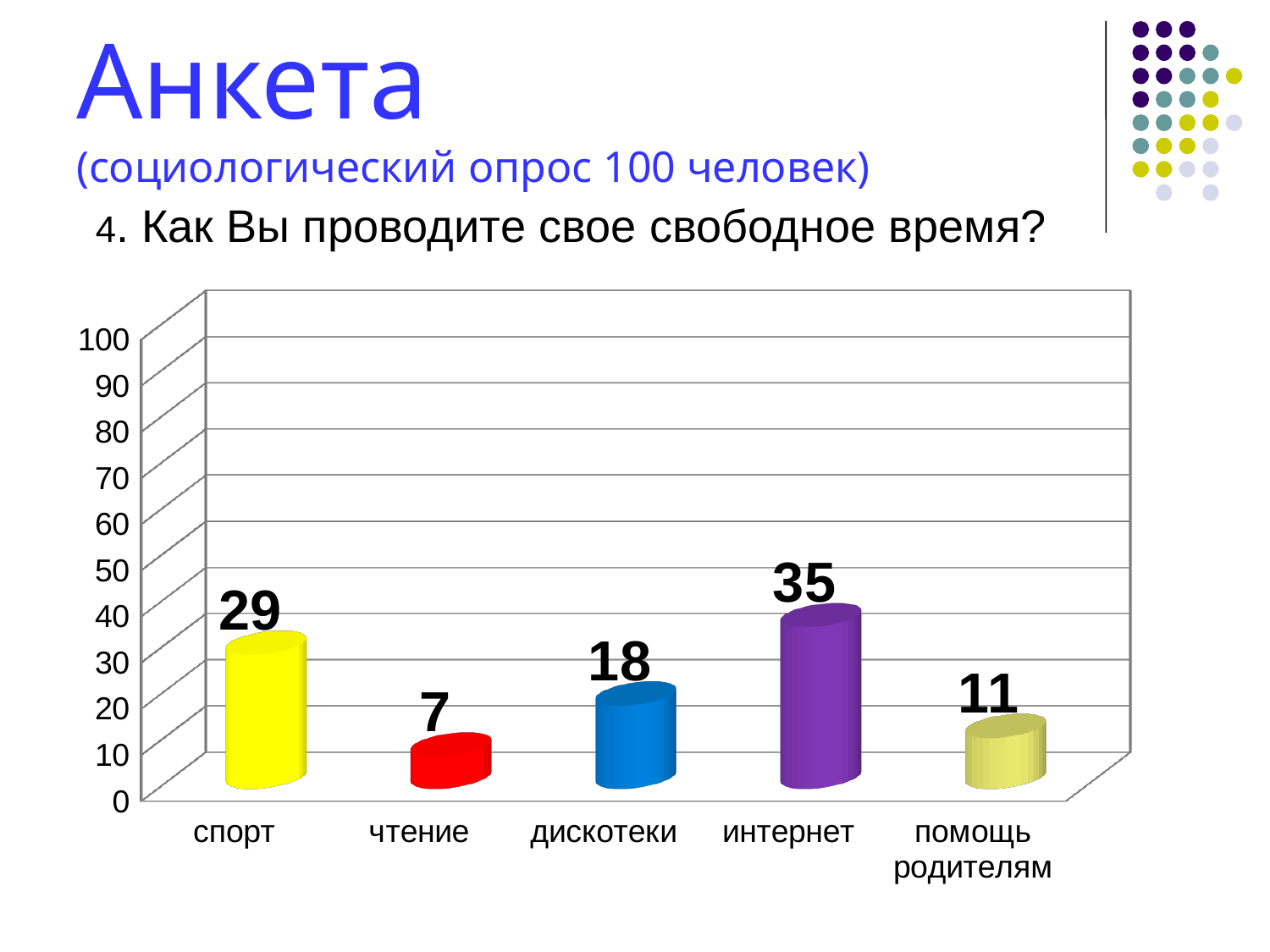
How many categories are shown on the chart? 5 What is the value for чтение? 7 What colour is the bar for интернет? purple What kind of chart is shown on the slide? bar chart Which is larger, the value for дискотеки or the value for помощь родителям? дискотеки Which category has the highest value? интернет What is the difference between the values for интернет and спорт? 6 Is the value for дискотеки greater or less than 20? less What is the value for помощь родителям? 11 Which category has the lowest value? чтение What is the value for спорт? 29 What is the value for интернет? 35